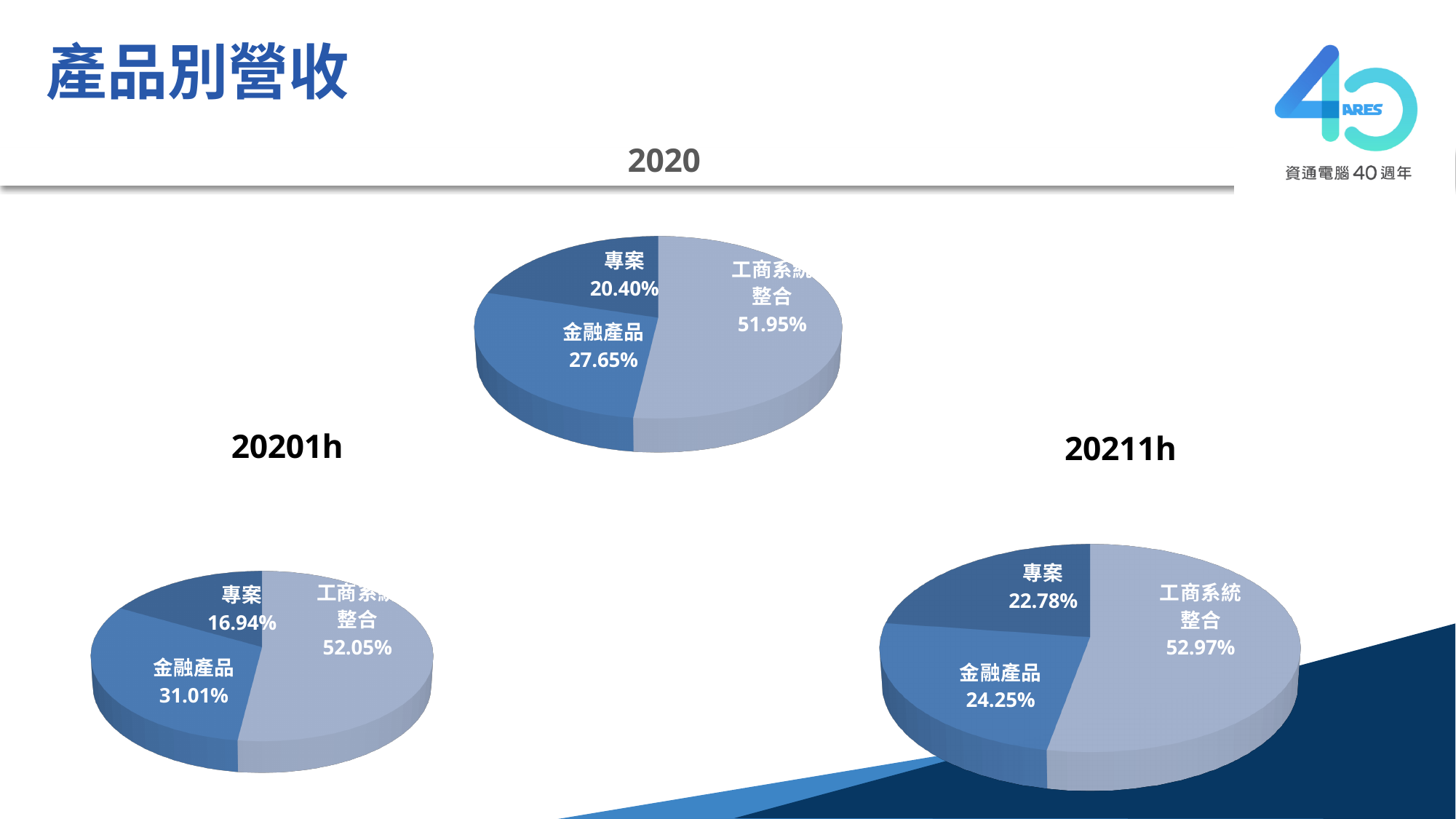
In the 20211h chart, which category has the largest share? 工商系統整合 In the 2020 chart, what share does 金融產品 have? 27.65% In the 20201h chart, what share does 專案 have? 16.94% In the 20201h chart, which category has the smallest share? 專案 In the 2020 chart, what share does 工商系統整合 have? 51.95% In the 20201h chart, which is larger: 金融產品 or 專案? 金融產品 How many charts are shown on the slide? 3 In the 20211h chart, what share does 金融產品 have? 24.25% How many slices does the 20211h chart have? 3 In the 2020 chart, what is the difference between the shares of 金融產品 and 專案? 7.25% What type of chart is used for 2020? Pie chart What is the title of the slide? 產品別營收